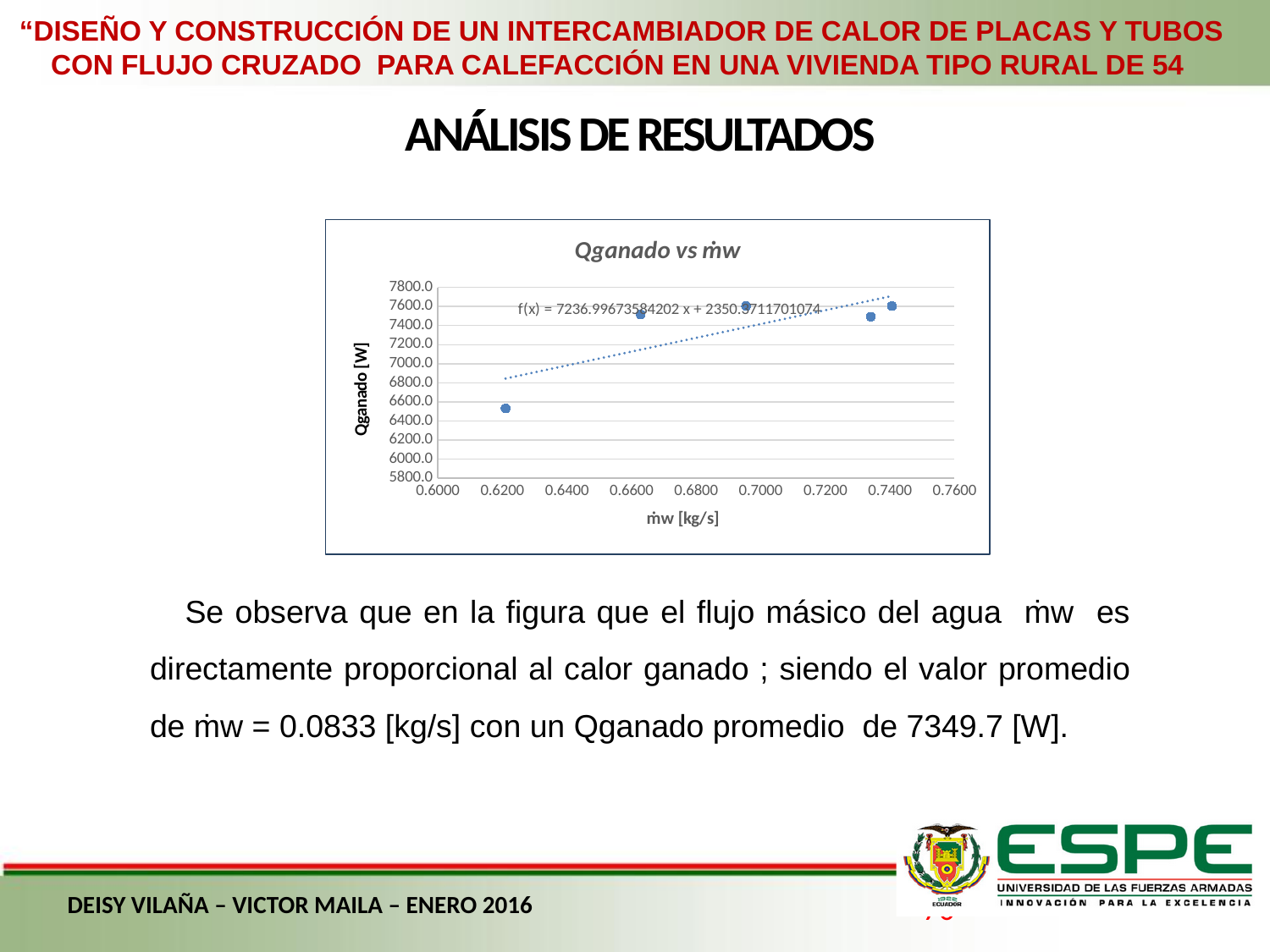
Is the Qganado value of the data point near ṁw = 0.6600 greater or less than 7200.0? greater What is the lowest tick value shown on the x axis? 0.6000 Do the plotted Qganado values generally rise or fall as ṁw increases along the x axis? rise What is the trendline equation shown on the chart? f(x) = 7236.99673584202 x + 2350.9711701074 Is the Qganado value of the rightmost data point (near ṁw = 0.7400) greater or less than 7400.0? greater What kind of chart is shown on the slide? scatter chart What is the title of the chart? Qganado vs ṁw Which data point has the lowest Qganado value: the one near ṁw = 0.6200 or the one near ṁw = 0.7400? the one near ṁw = 0.6200 What is the label of the y axis? Qganado [W] Is the Qganado value of the leftmost data point (near ṁw = 0.6200) greater or less than 6800.0? less How many data points are plotted in the chart? 5 What is the highest tick value shown on the y axis? 7800.0